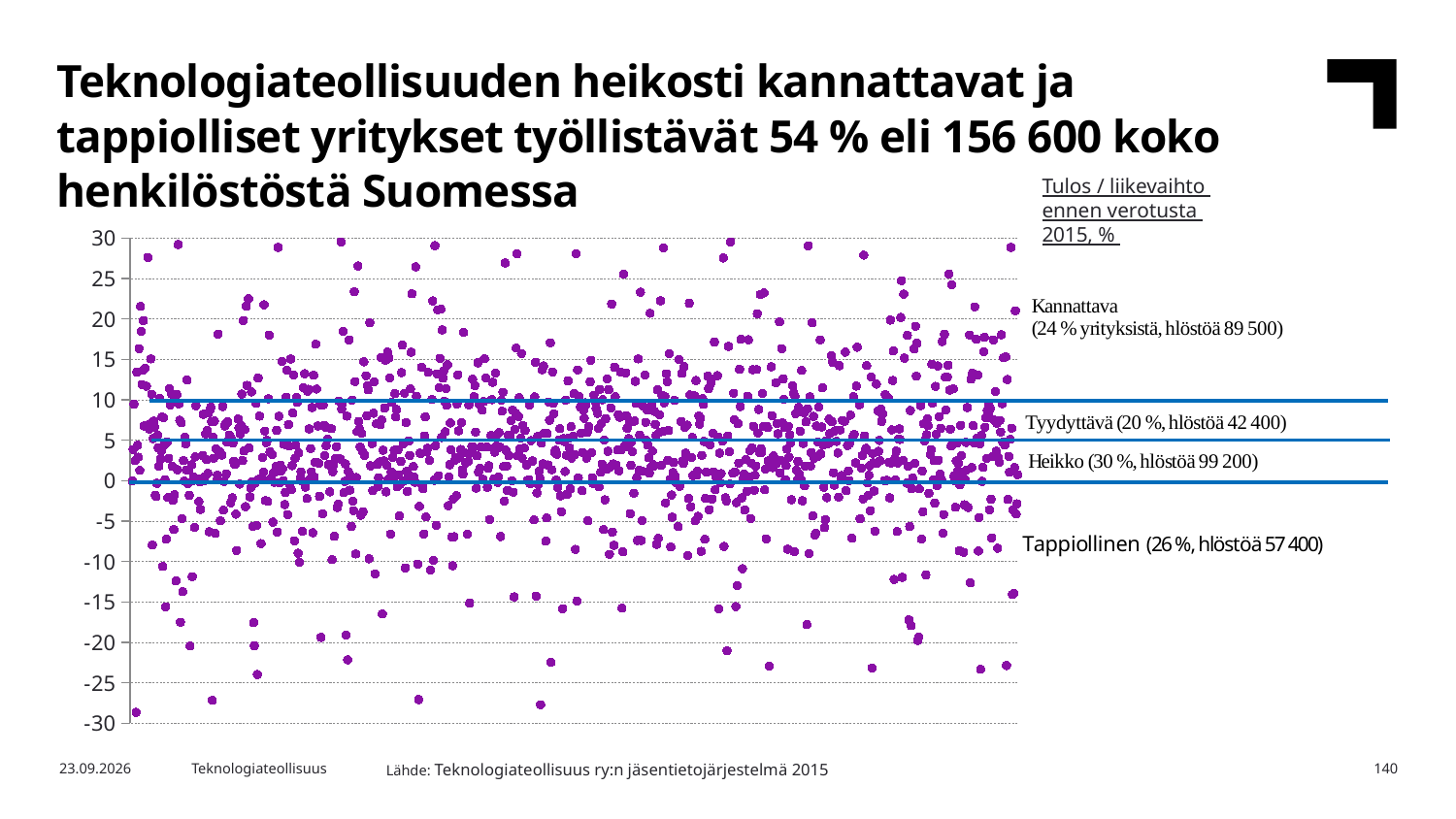
How many profitability groups (Kannattava, Tyydyttävä, Heikko, Tappiollinen) are labelled on the chart? 4 Which labelled group has the smallest number of personnel? Tyydyttävä What percentage of companies are in the Tappiollinen group according to the chart annotation? 26 % How many personnel (hlöstöä) does the Tyydyttävä group have according to the chart annotation? 42 400 Which labelled group has the largest share of companies? Heikko How many personnel (hlöstöä) does the Heikko group have according to the chart annotation? 99 200 What is the title of the chart (the text above the annotations on the right)? Tulos / liikevaihto ennen verotusta 2015, % What is the highest value shown on the vertical axis of the chart? 30 What is the difference in personnel between the Heikko group (99 200) and the Kannattava group (89 500)? 9 700 What percentage of companies are in the Kannattava group according to the chart annotation? 24 % Which group has more personnel, Tappiollinen or Tyydyttävä? Tappiollinen What kind of chart is shown on the slide? Scatter chart